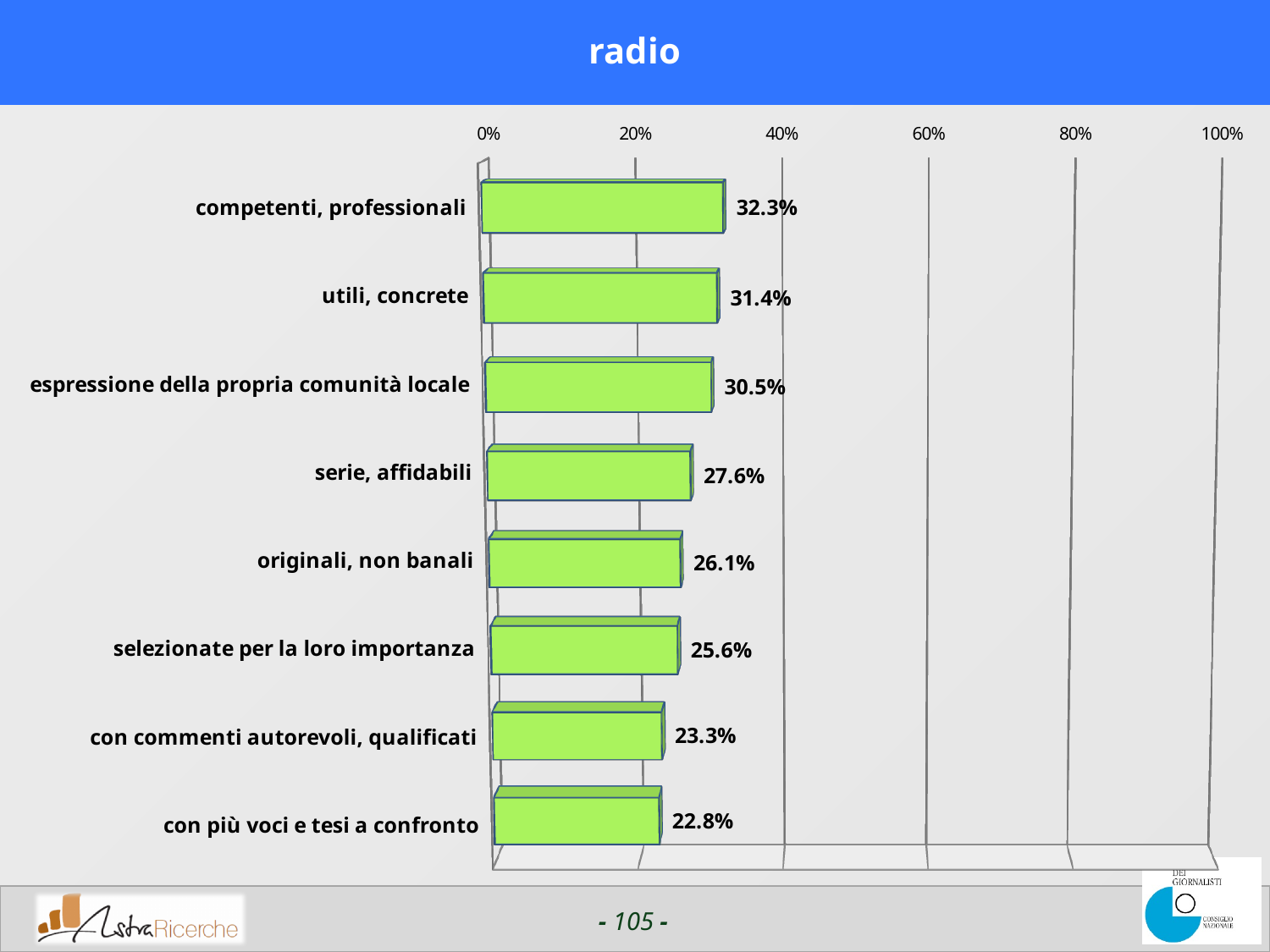
What is the value for "con commenti autorevoli, qualificati"? 23.3% What is the difference between "competenti, professionali" and "con più voci e tesi a confronto"? 9.5% Which category has the lowest value? con più voci e tesi a confronto What kind of chart is shown on the slide? bar chart Which is larger: "espressione della propria comunità locale" or "selezionate per la loro importanza"? espressione della propria comunità locale How many categories are shown in the chart? 8 Which category has the highest value? competenti, professionali What is the value for "competenti, professionali"? 32.3% Is the value for "utili, concrete" greater or less than 40%? less What is the difference between "utili, concrete" and "originali, non banali"? 5.3% What is the title of the slide? radio What is the value for "serie, affidabili"? 27.6%